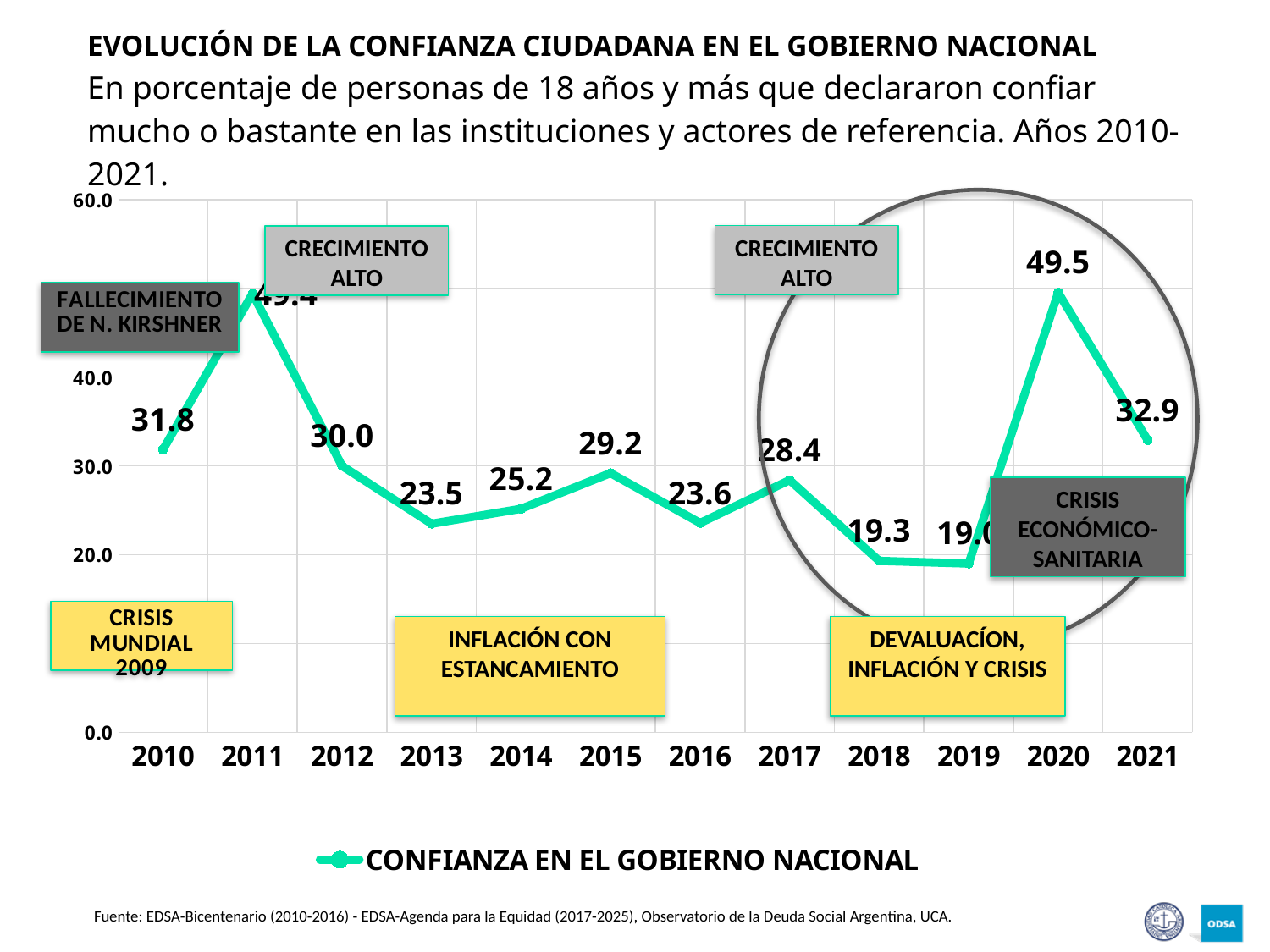
What is the value for 2020? 49.5 What is the value for 2013? 23.5 What is the difference between the values for 2020 and 2021? 16.6 What is the value for 2021? 32.9 What is the value for 2017? 28.4 How many series does the legend list? 1 How many years are plotted on the x axis? 12 What kind of chart is shown on the slide? line chart Is the value for 2018 greater or less than 20.0? less Does the value rise or fall from 2012 to 2013? fall What is the value for 2010? 31.8 Which year has the larger value, 2015 or 2016? 2015